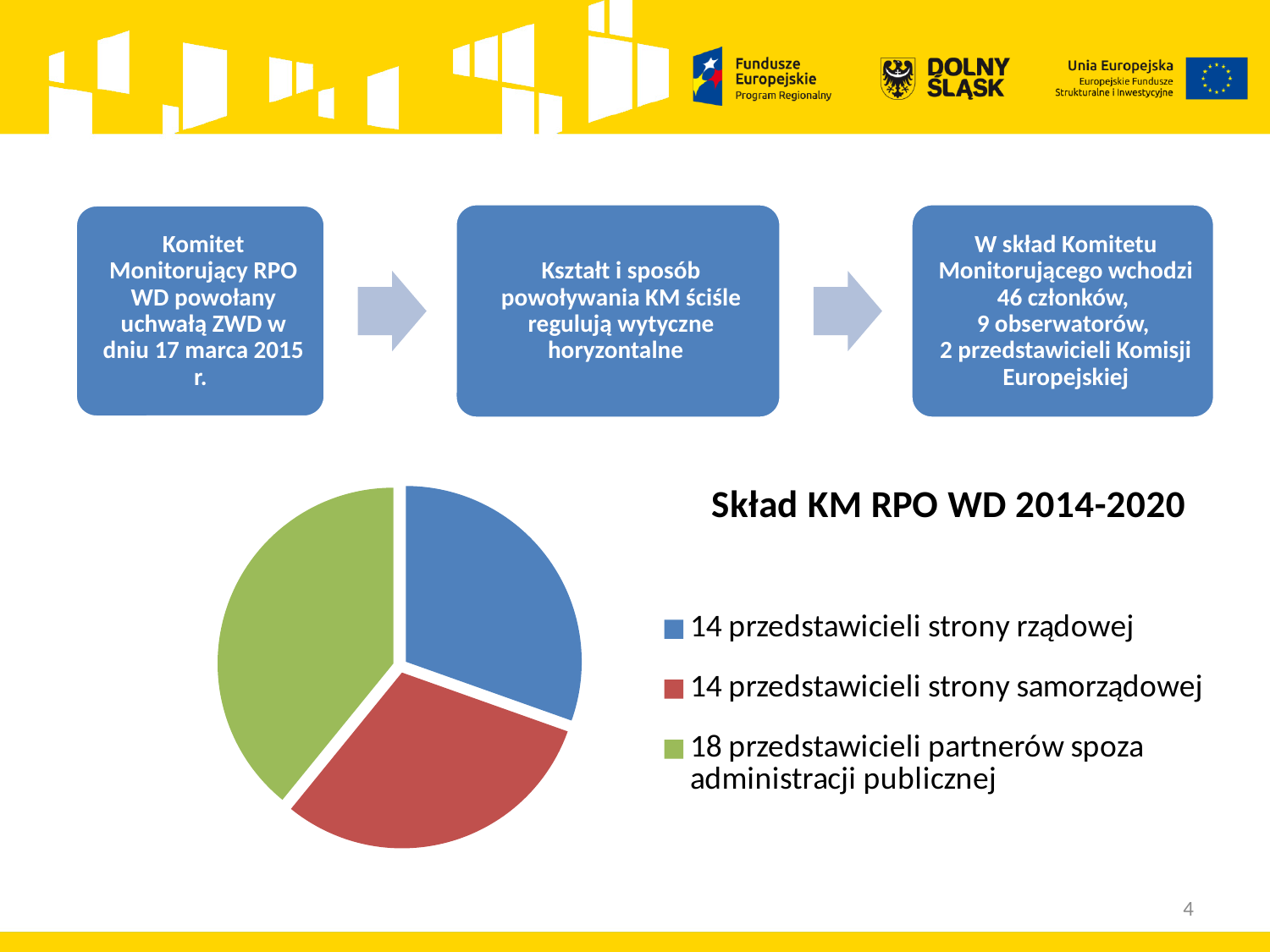
What kind of chart is shown on the slide? pie chart How many representatives of the local-government side (strona samorządowa) are shown in the pie chart legend? 14 How many entries does the legend of the pie chart list? 3 What is the difference between the number of partners from outside public administration and the number of government-side representatives? 4 Which group has the largest slice in the pie chart? 18 przedstawicieli partnerów spoza administracji publicznej How many representatives of the government side (strona rządowa) are shown in the pie chart legend? 14 How many representatives of partners from outside public administration are shown in the pie chart legend? 18 What colour is the slice for partners from outside public administration? green What is the title of the pie chart? Skład KM RPO WD 2014-2020 How many slices does the pie chart have? 3 What is the total number of representatives across all three slices of the pie chart? 46 Which is larger: the slice for partners from outside public administration or the slice for the government side? partners from outside public administration